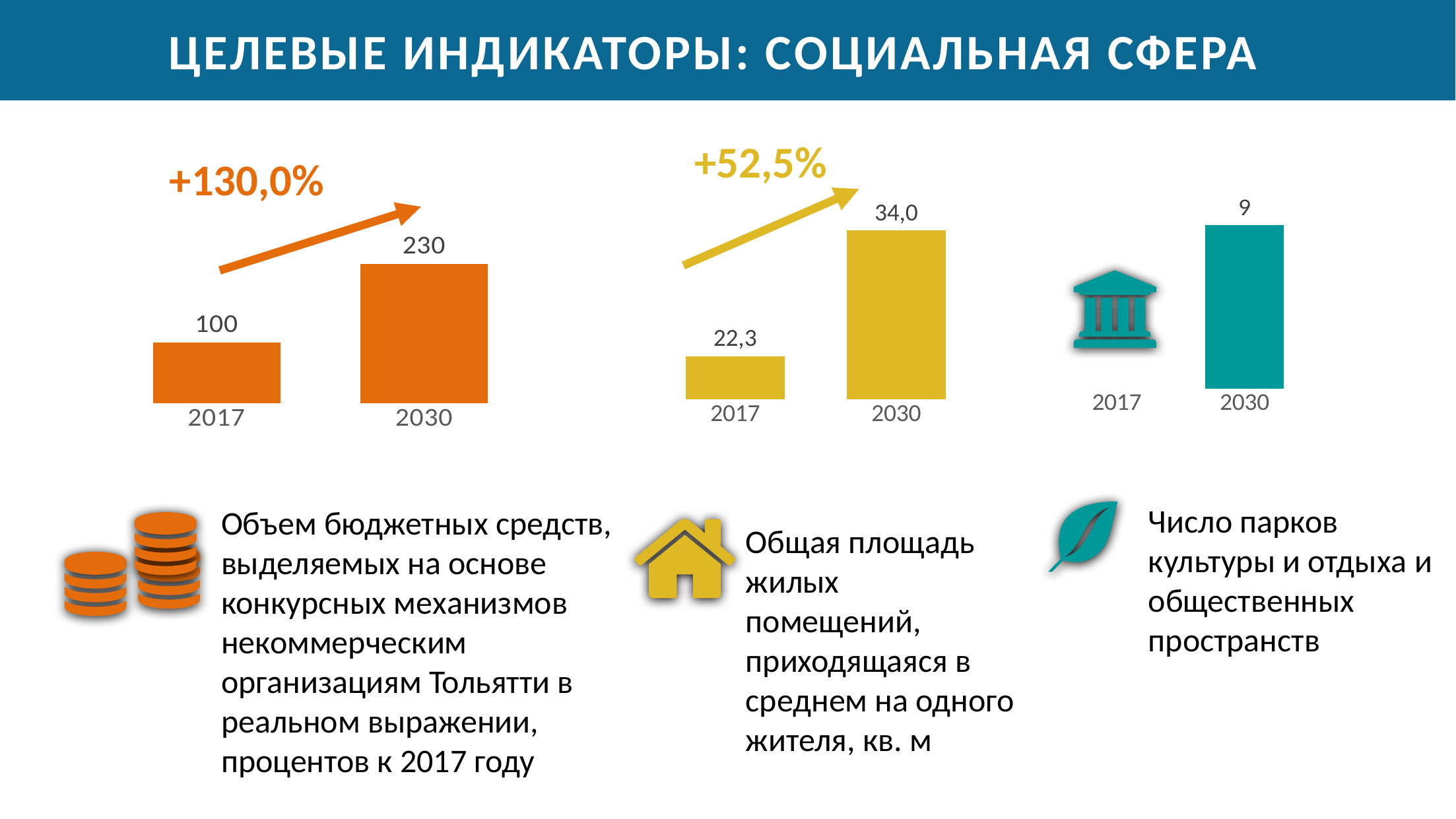
In the left chart (orange bars), what is the value for 2030? 230 In the middle chart (yellow bars), which year has the higher value? 2030 In the left chart (orange bars), what is the difference between the 2030 and 2017 values? 130 In the left chart (orange bars), what is the value for 2017? 100 What type of chart is the left chart (orange)? Bar chart In the middle chart (yellow bars), what is the value for 2030? 34,0 In the right chart (teal bar), what is the value for 2030? 9 What percentage change is printed above the left chart (orange bars)? +130,0% In the middle chart (yellow bars), what is the value for 2017? 22,3 What percentage change is printed above the middle chart (yellow bars)? +52,5% How many years are shown on the x axis of the middle chart (yellow bars)? 2 In the left chart (orange bars), do the values rise or fall from 2017 to 2030? Rise